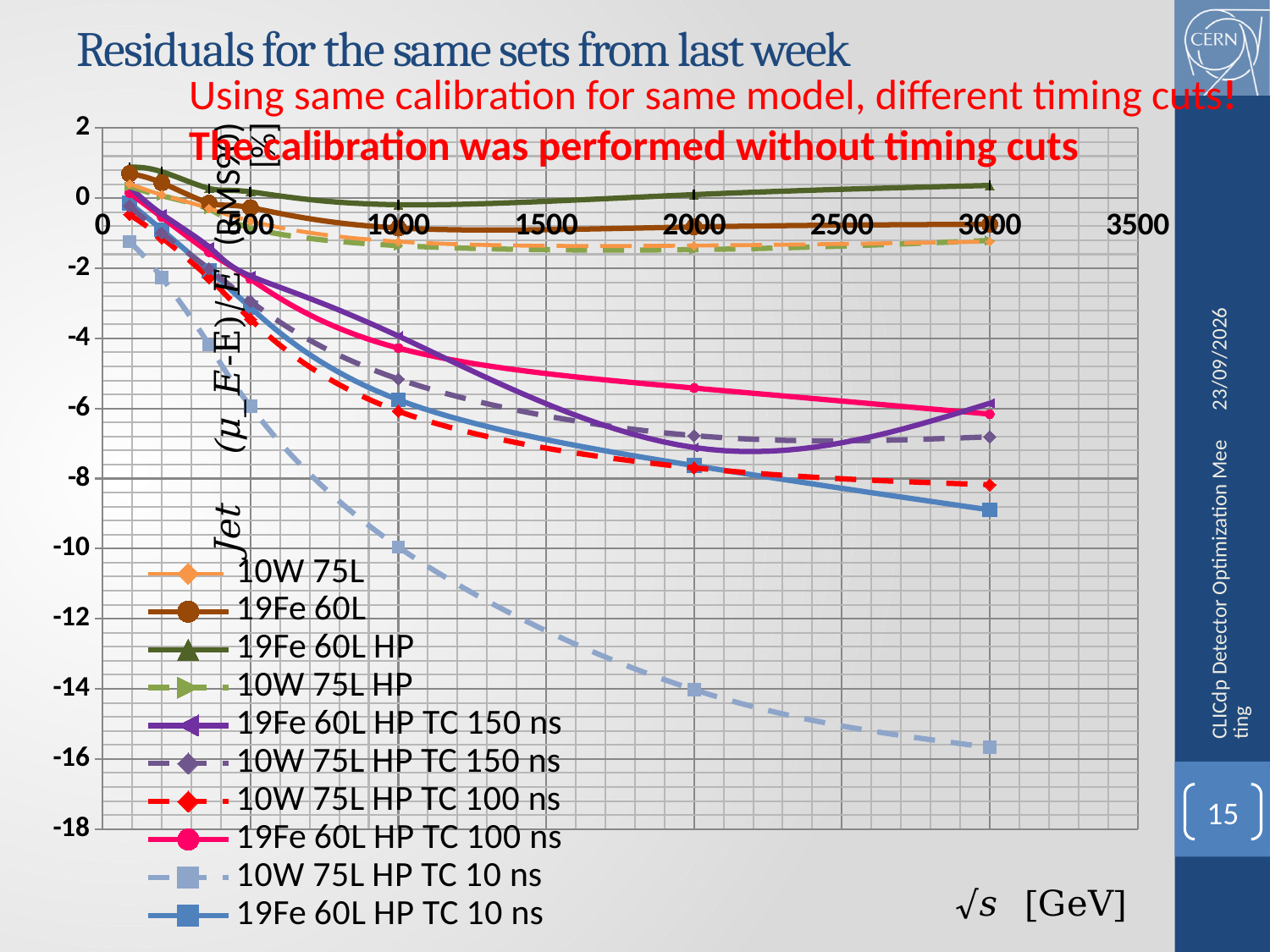
What kind of chart is shown on the slide? line chart Which series has the highest value at 3000 GeV? 19Fe 60L HP Is the value for 19Fe 60L HP TC 100 ns at 2000 GeV greater or less than -6? greater Is the value for 19Fe 60L HP TC 10 ns at 3000 GeV greater or less than -8? less What is the label of the x axis? √s [GeV] Is the value for 10W 75L HP TC 10 ns at 3000 GeV greater or less than -14? less How many series does the legend list? 10 Does the 10W 75L HP TC 10 ns series rise or fall as √s increases along the x axis? fall Which series has the lowest value at 3000 GeV? 10W 75L HP TC 10 ns At 3000 GeV, which is larger: the value for 19Fe 60L HP TC 100 ns or for 10W 75L HP TC 100 ns? 19Fe 60L HP TC 100 ns